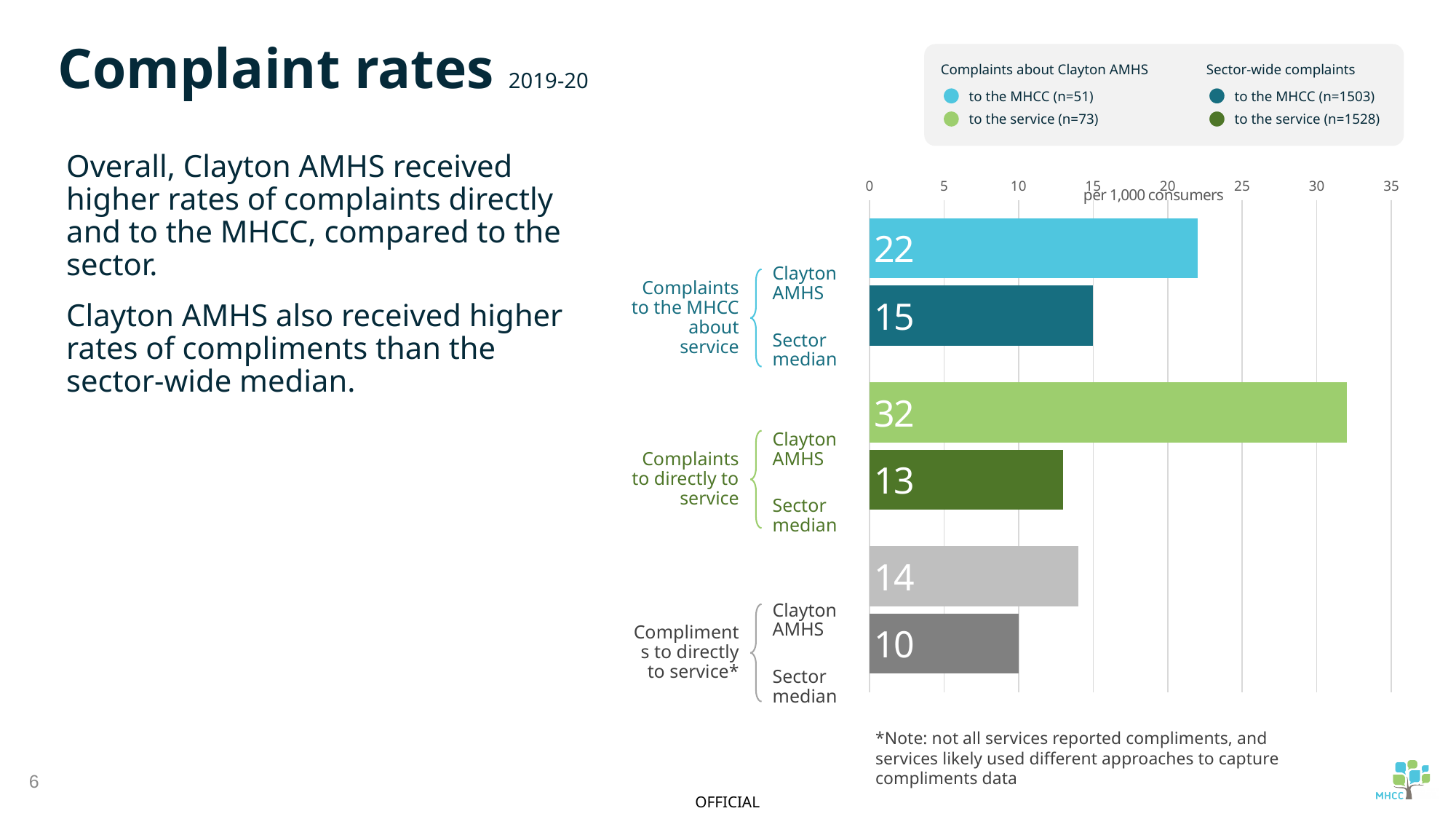
What unit does the chart's axis use? per 1,000 consumers Which is larger: the Clayton AMHS rate of compliments directly to service or the sector median rate of compliments directly to service? Clayton AMHS What is the rate of complaints to the MHCC about service for Clayton AMHS? 22 Which bar has the lowest value on the chart? Compliments directly to service, Sector median What is the difference between the Clayton AMHS and sector median rates of complaints to the MHCC about service? 7 How many bars are plotted on the chart? 6 What is the sector median rate of compliments directly to service? 10 What is the difference between the Clayton AMHS and sector median rates of complaints directly to service? 19 Which bar has the highest value on the chart? Complaints directly to service, Clayton AMHS What type of chart is shown on the slide? Bar chart What is the sector median rate of complaints to the MHCC about service? 15 What is the rate of complaints directly to service for Clayton AMHS? 32